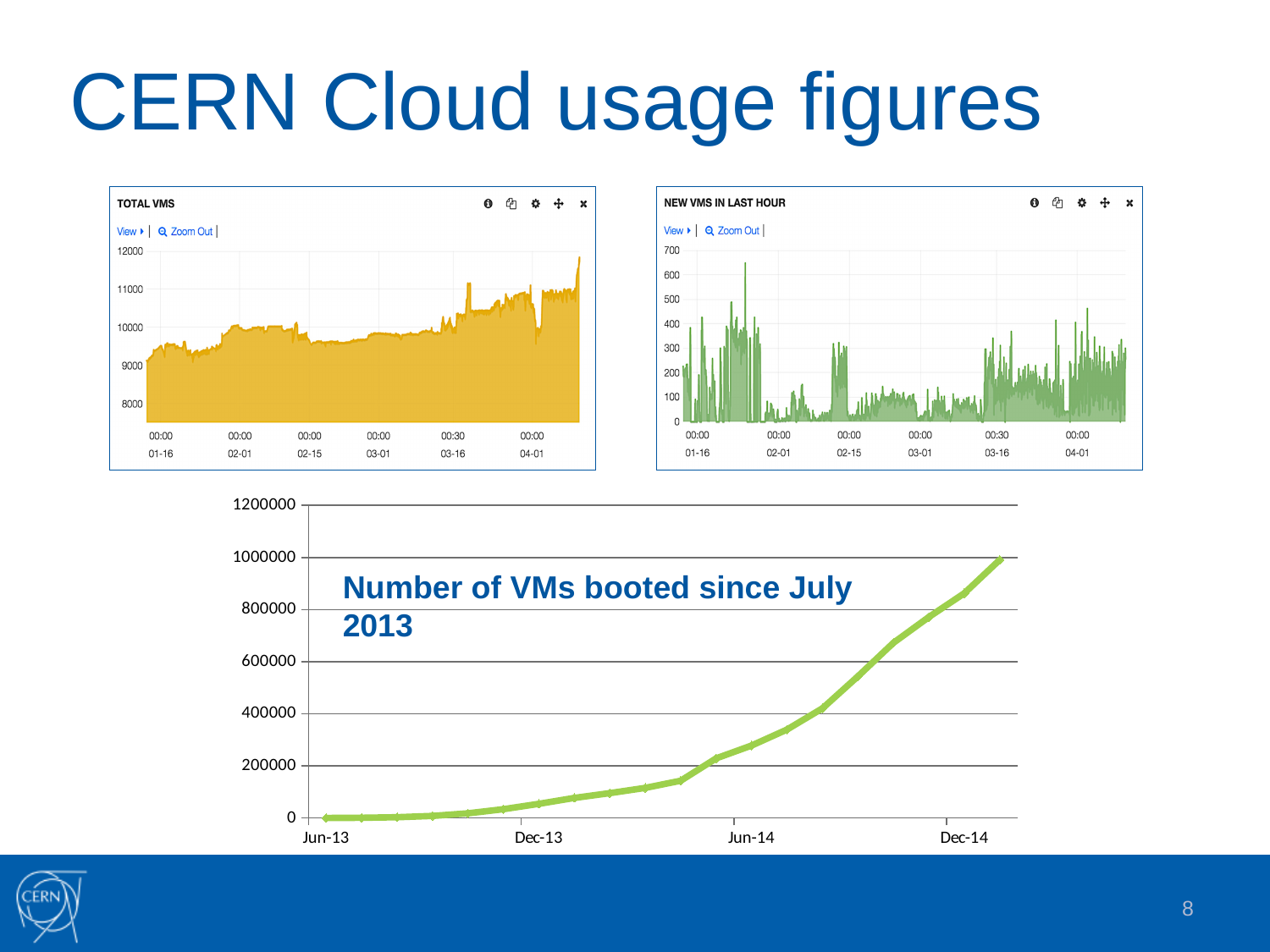
In the bottom chart 'Number of VMs booted since July 2013', what is the highest value shown on the y axis? 1200000 In the top-left chart 'TOTAL VMS', is the value at the end of the series (after 04-01) greater or less than 11000? greater What kind of chart is the bottom chart titled 'Number of VMs booted since July 2013'? line chart How many charts are shown on the slide? 3 In the bottom chart 'Number of VMs booted since July 2013', do the values rise or fall from Jun-13 to Dec-14? rise In the top-right chart 'NEW VMS IN LAST HOUR', is the highest peak greater or less than 600? greater In the bottom chart 'Number of VMs booted since July 2013', is the value at Jun-14 greater or less than 200000? greater What is the title of the top-left chart? TOTAL VMS In the top-right chart 'NEW VMS IN LAST HOUR', what is the highest value shown on the y axis? 700